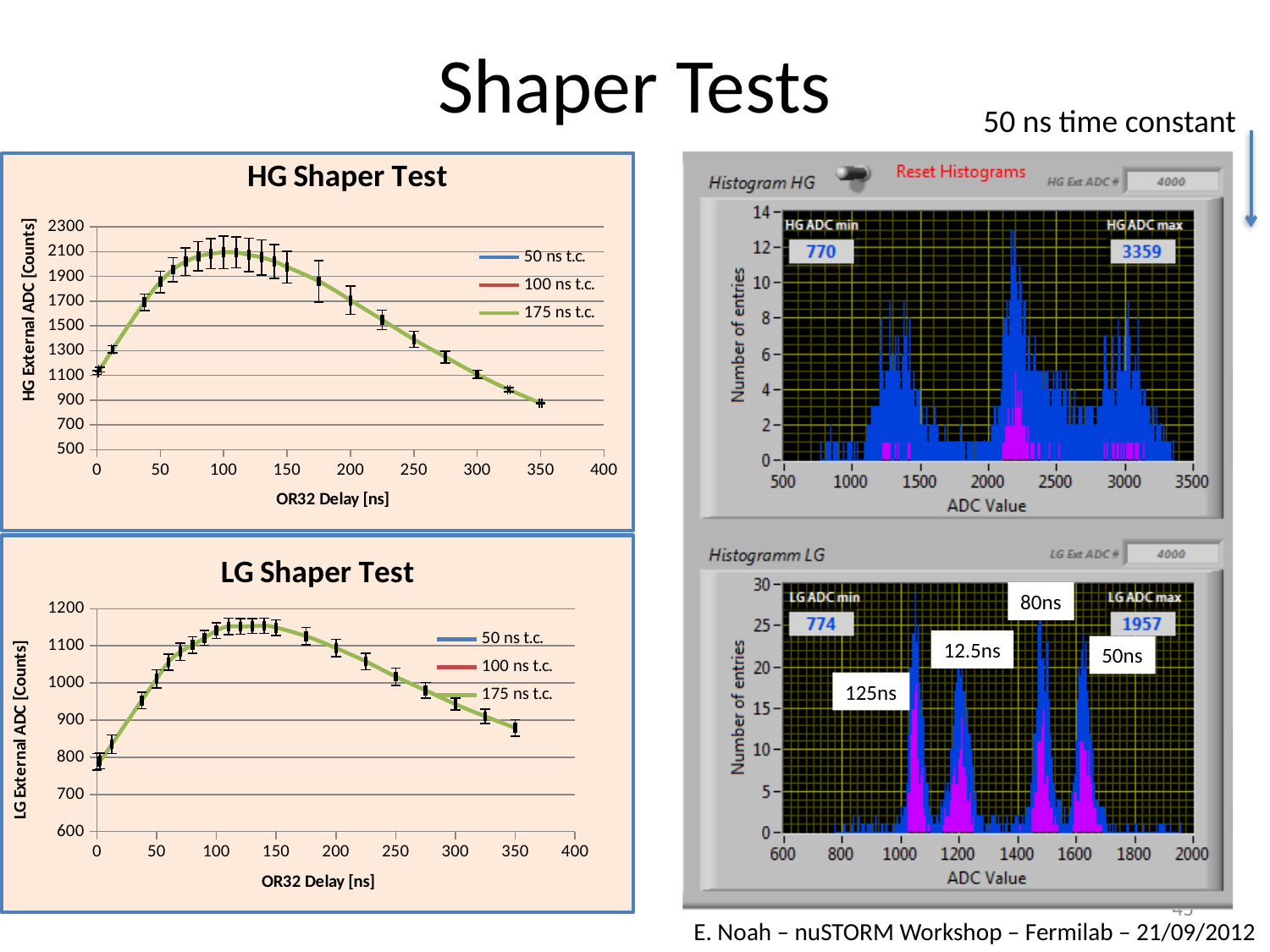
What is the HG ADC max value shown on the Histogram HG panel? 3359 In the LG Shaper Test chart, is the value at an OR32 delay of 0 ns greater or less than 900? less What is the HG ADC min value shown on the Histogram HG panel? 770 In the LG Shaper Test chart, do the values rise or fall as the OR32 delay increases from 0 ns to 100 ns? rise In the HG Shaper Test chart, do the values rise or fall as the OR32 delay increases from 100 ns to 350 ns? fall In the HG Shaper Test chart, is the value at an OR32 delay of 100 ns greater or less than 1900? greater In the LG Shaper Test chart, is the value at an OR32 delay of 200 ns greater or less than 1000? greater What kind of chart is the HG Shaper Test? line chart How many series does the legend of the LG Shaper Test chart list? 3 What is the LG ADC max value shown on the Histogramm LG panel? 1957 What is the x-axis label of the LG Shaper Test chart? OR32 Delay [ns]